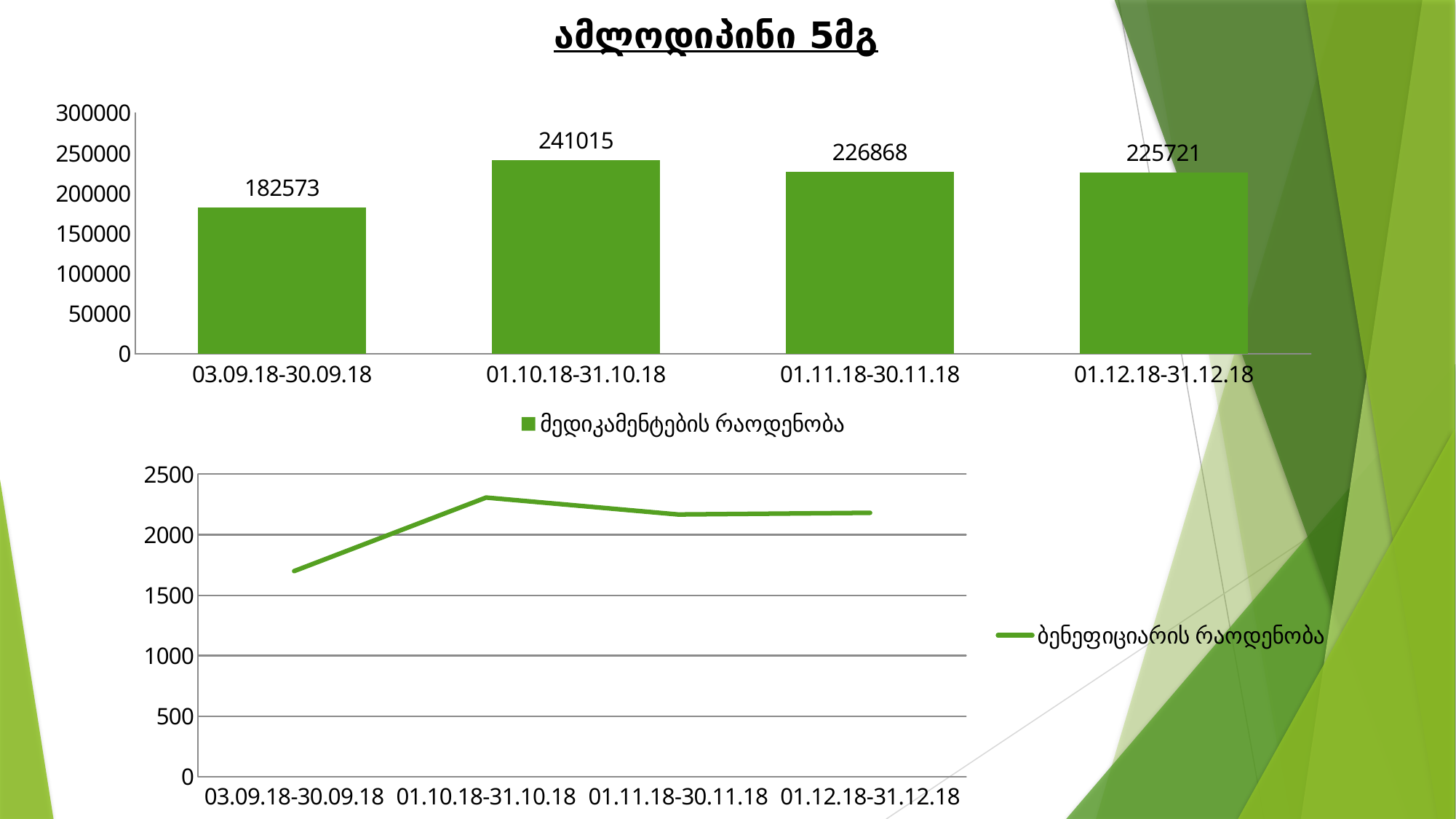
In the bottom line chart, is the value for 03.09.18-30.09.18 greater or less than 2000? less What is the legend entry of the bottom line chart? ბენეფიციარის რაოდენობა In the top bar chart, which is larger: the value for 01.11.18-30.11.18 or 01.12.18-31.12.18? 01.11.18-30.11.18 In the top bar chart, what is the value for 01.10.18-31.10.18? 241015 In the top bar chart, what is the value for 03.09.18-30.09.18? 182573 What type of chart is the bottom chart on the slide? Line chart In the top bar chart, which period has the highest value? 01.10.18-31.10.18 How many periods are shown in the top bar chart? 4 In the bottom line chart, is the value for 01.10.18-31.10.18 greater or less than 2000? greater In the top bar chart, what is the value for 01.12.18-31.12.18? 225721 In the top bar chart, which period has the lowest value? 03.09.18-30.09.18 In the top bar chart, what is the difference between the values for 01.10.18-31.10.18 and 03.09.18-30.09.18? 58442